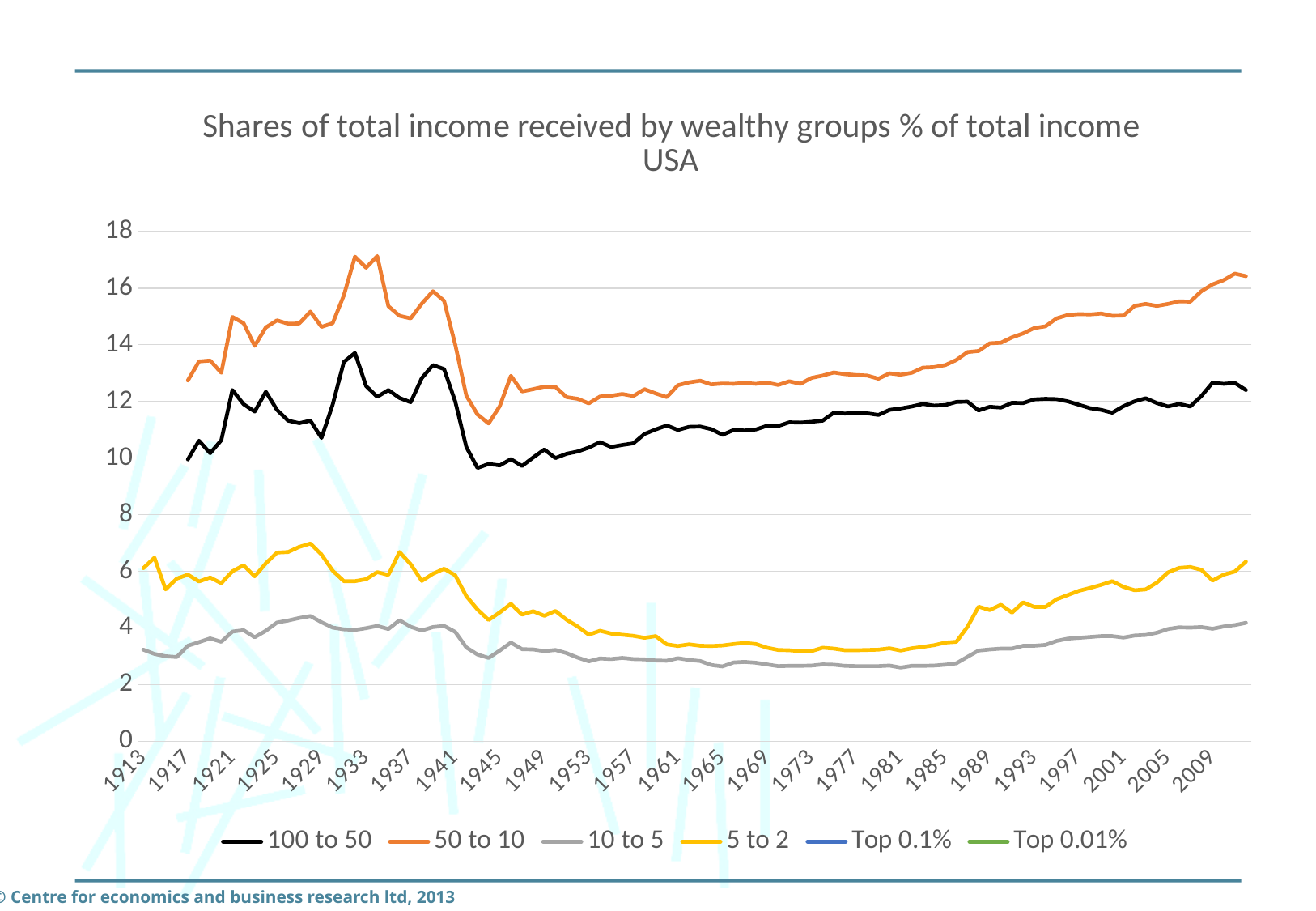
Is the value for '50 to 10' in 1933 greater or less than 16? greater Which plotted series has the highest values across the whole chart? 50 to 10 What kind of chart is shown on the slide? line chart What is the title of the chart? Shares of total income received by wealthy groups % of total income USA Is the value for '50 to 10' in 2009 greater or less than 14? greater Is the value for '100 to 50' in 1945 greater or less than 12? less How many series does the legend list? 6 In 1933, which series has the larger value: '50 to 10' or '100 to 50'? 50 to 10 What colour is the line for the '5 to 2' series? yellow In 1989, which series has the larger value: '5 to 2' or '10 to 5'? 5 to 2 Does the '50 to 10' series rise or fall between 1981 and 2009? rise